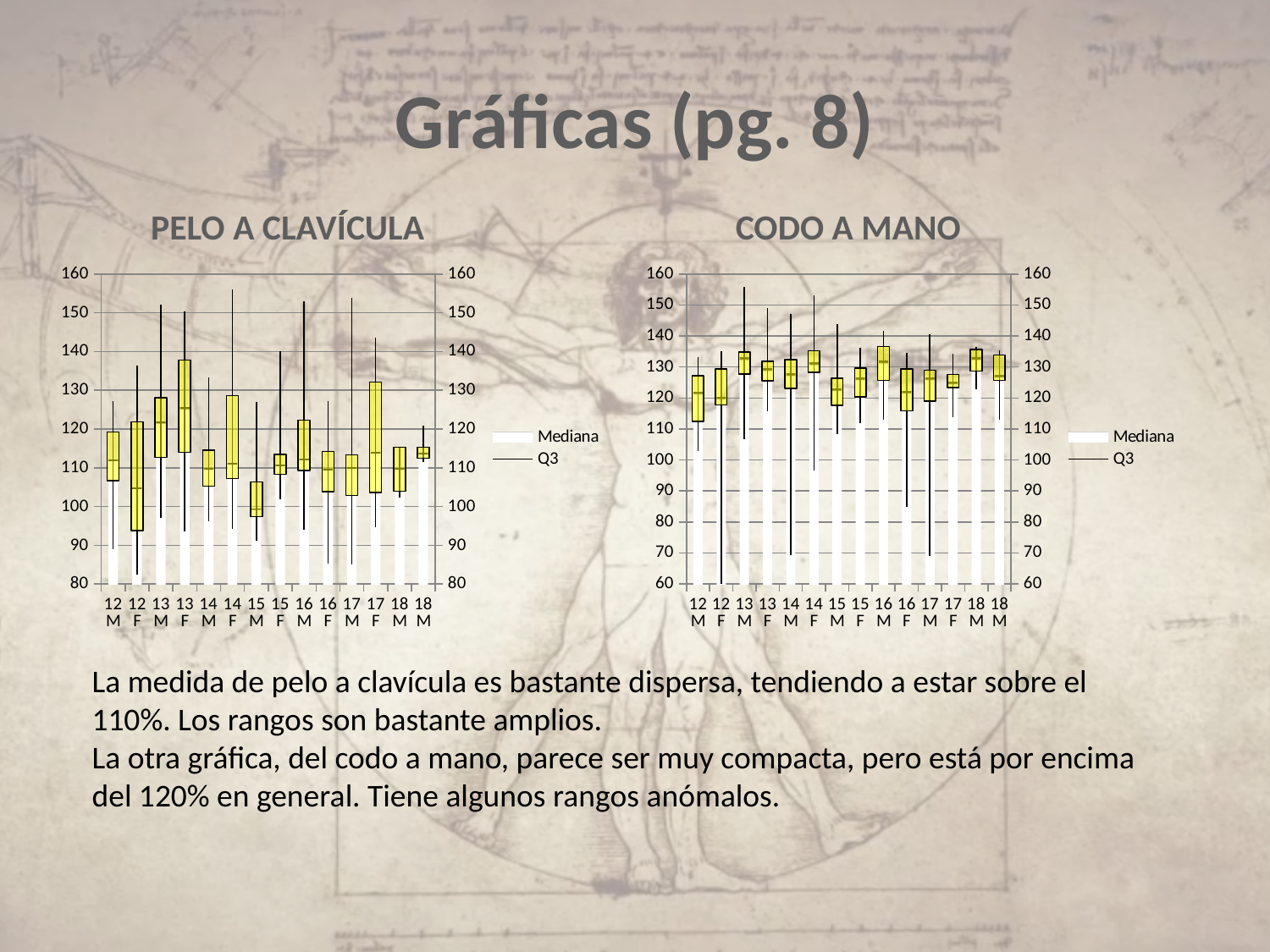
What kind of chart is the CODO A MANO chart? Box plot How many categories are shown on the x axis of the PELO A CLAVÍCULA chart? 14 In the PELO A CLAVÍCULA chart, is the top of the box for 13 F greater or less than 130? greater What is the lowest value shown on the vertical axis of the CODO A MANO chart? 60 In the CODO A MANO chart, which box is higher, 18 M or 12 M? 18 M In the PELO A CLAVÍCULA chart, is the top of the box for 15 M greater or less than 110? less What are the two legend entries of the CODO A MANO chart? Mediana and Q3 How many categories are shown on the x axis of the CODO A MANO chart? 14 In the CODO A MANO chart, is the bottom of the box for 18 M greater or less than 120? greater How many series does the legend of the PELO A CLAVÍCULA chart list? 2 In the PELO A CLAVÍCULA chart, which box is higher, 13 F or 15 M? 13 F